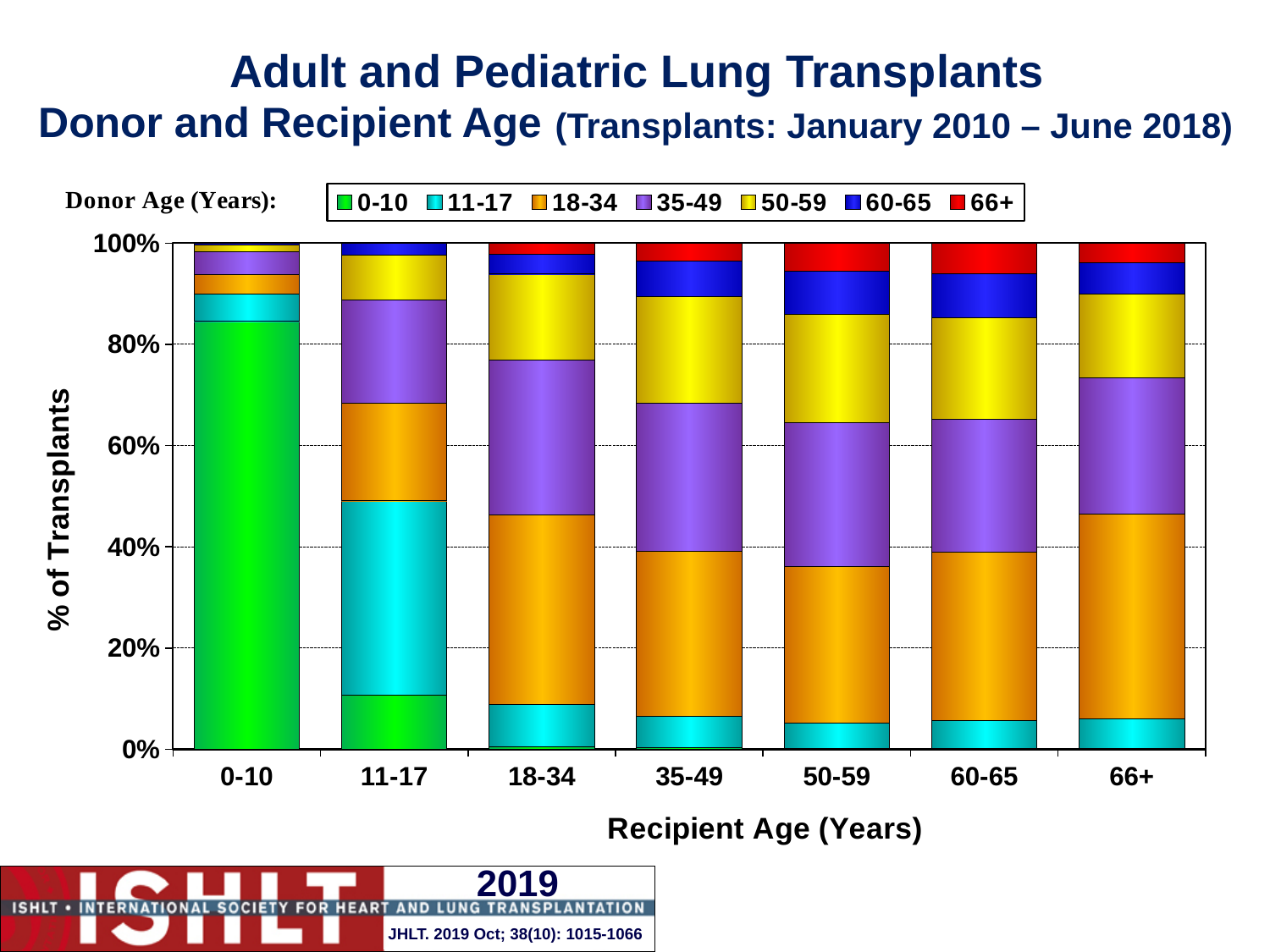
Is the share of transplants from donors aged 0-10 among recipients aged 0-10 greater or less than 80%? greater What kind of chart is shown on the slide? Stacked bar chart Is the share of transplants from donors aged 18-34 larger for recipients aged 66+ or for recipients aged 50-59? 66+ Which recipient age group has the largest share of transplants from donors aged 0-10? 0-10 Is the share of transplants from donors aged 35-49 among recipients aged 35-49 greater or less than 40%? less Is the share of transplants from donors aged 18-34 among recipients aged 18-34 greater or less than 20%? greater Which recipient age group has the largest share of transplants from donors aged 11-17? 11-17 How many recipient age groups are shown along the x axis? 7 How many donor age groups does the legend list? 7 What is the title of the x axis? Recipient Age (Years) What is the title of the y axis? % of Transplants